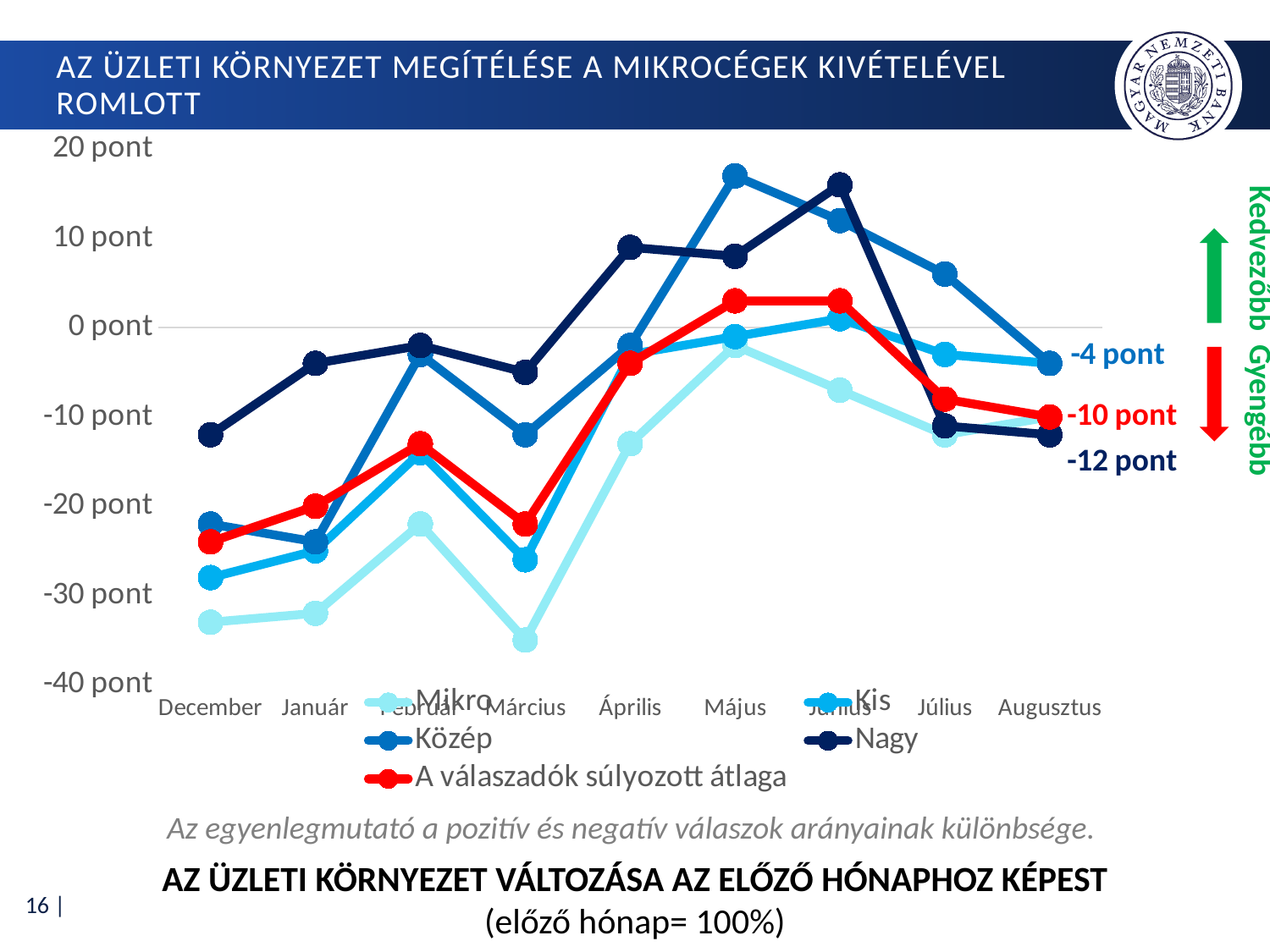
Which series has the lowest value in December? Mikro How many months are shown along the x axis? 9 Is the value for Közép in Május greater or less than 10 pont? greater What kind of chart is shown on the slide? line chart What is the value for Nagy in Augusztus? -12 pont Is the value for Mikro in Március greater or less than -30 pont? less In December, which is higher: Mikro or Nagy? Nagy What is the value for A válaszadók súlyozott átlaga in Augusztus? -10 pont Which series has the highest value in Június? Nagy Does the Mikro series rise or fall from Március to Május? rise How many series does the legend list? 5 What is the difference between A válaszadók súlyozott átlaga and Nagy in Augusztus? 2 pont